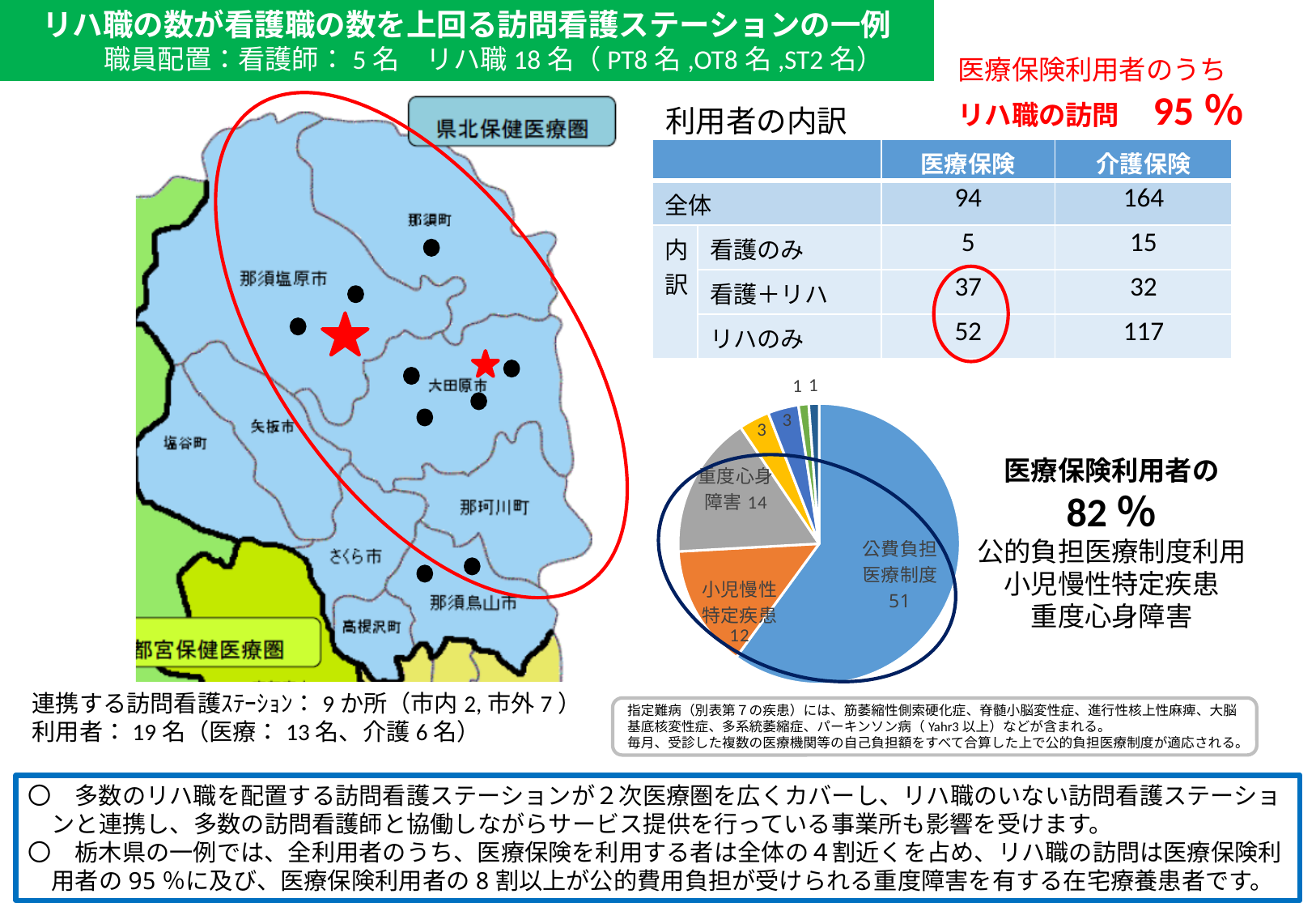
In the pie chart, what is the value for 小児慢性特定疾患? 12 What colour is the 公費負担医療制度 slice in the pie chart? blue In the pie chart, what is the difference between 公費負担医療制度 and 重度心身障害? 37 How many slices does the pie chart have? 7 Which slice of the pie chart is the largest? 公費負担医療制度 What kind of chart is shown on the slide? pie chart In the pie chart, which is larger: 重度心身障害 or 小児慢性特定疾患? 重度心身障害 In the pie chart, what is the value for 重度心身障害? 14 In the pie chart, what is the value for 公費負担医療制度? 51 In the pie chart, what is the difference between 公費負担医療制度 and 小児慢性特定疾患? 39 In the pie chart, what is the difference between 重度心身障害 and 小児慢性特定疾患? 2 What colour is the 小児慢性特定疾患 slice in the pie chart? orange